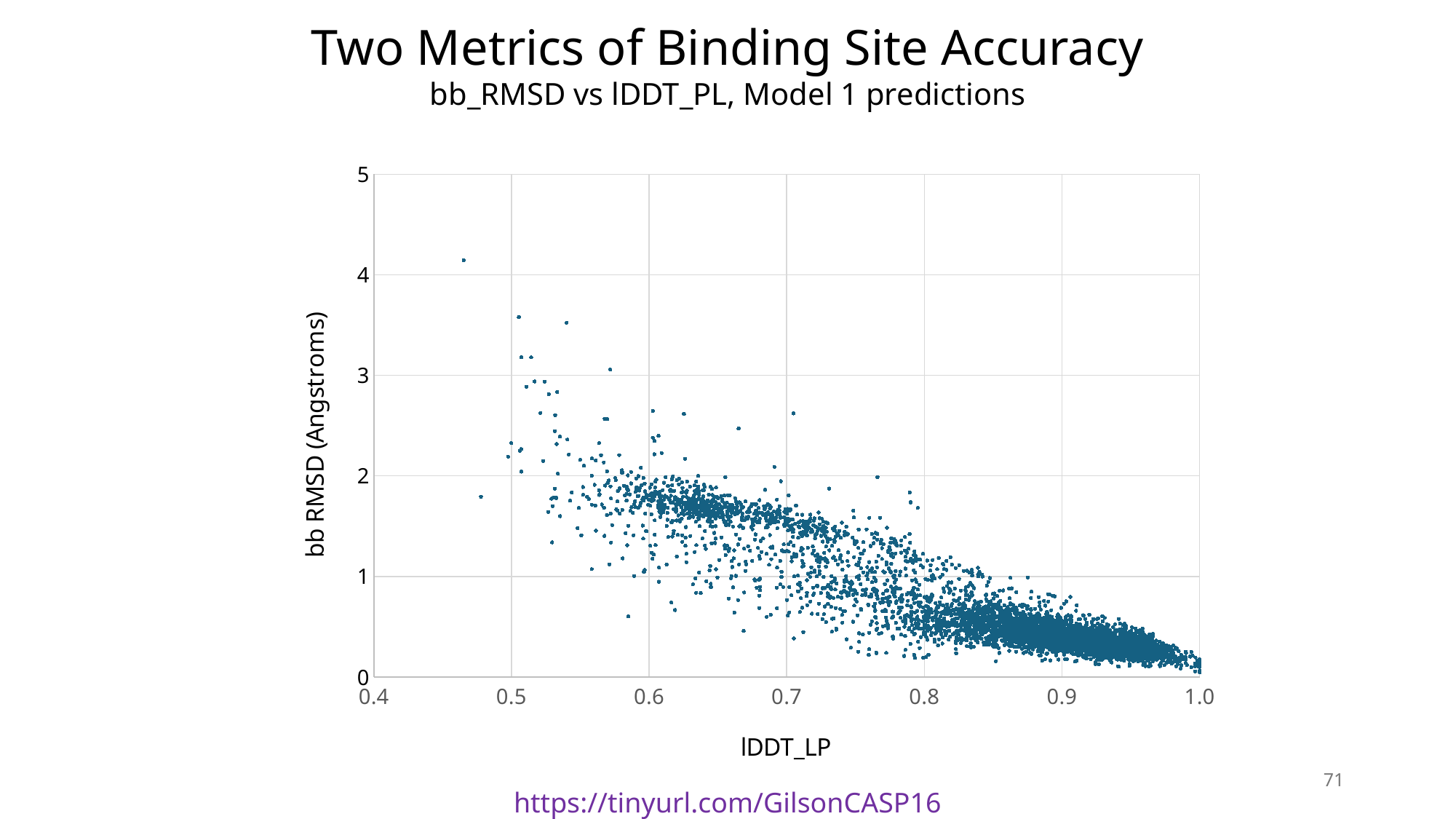
Which group of points generally has higher bb RMSD: those near lDDT_LP 0.6 or those near lDDT_LP 0.9? those near lDDT_LP 0.6 Is the highest bb RMSD value plotted greater or less than 4 Angstroms? greater What kind of chart is shown on the slide? scatter plot For points with lDDT_LP above 0.9, is the bb RMSD generally greater or less than 1 Angstrom? less Is the lowest lDDT_LP value plotted greater or less than 0.5? less What is the label of the y axis? bb RMSD (Angstroms) As lDDT_LP increases along the x axis, does bb RMSD generally rise or fall? fall What is the subtitle of the chart? bb_RMSD vs lDDT_PL, Model 1 predictions